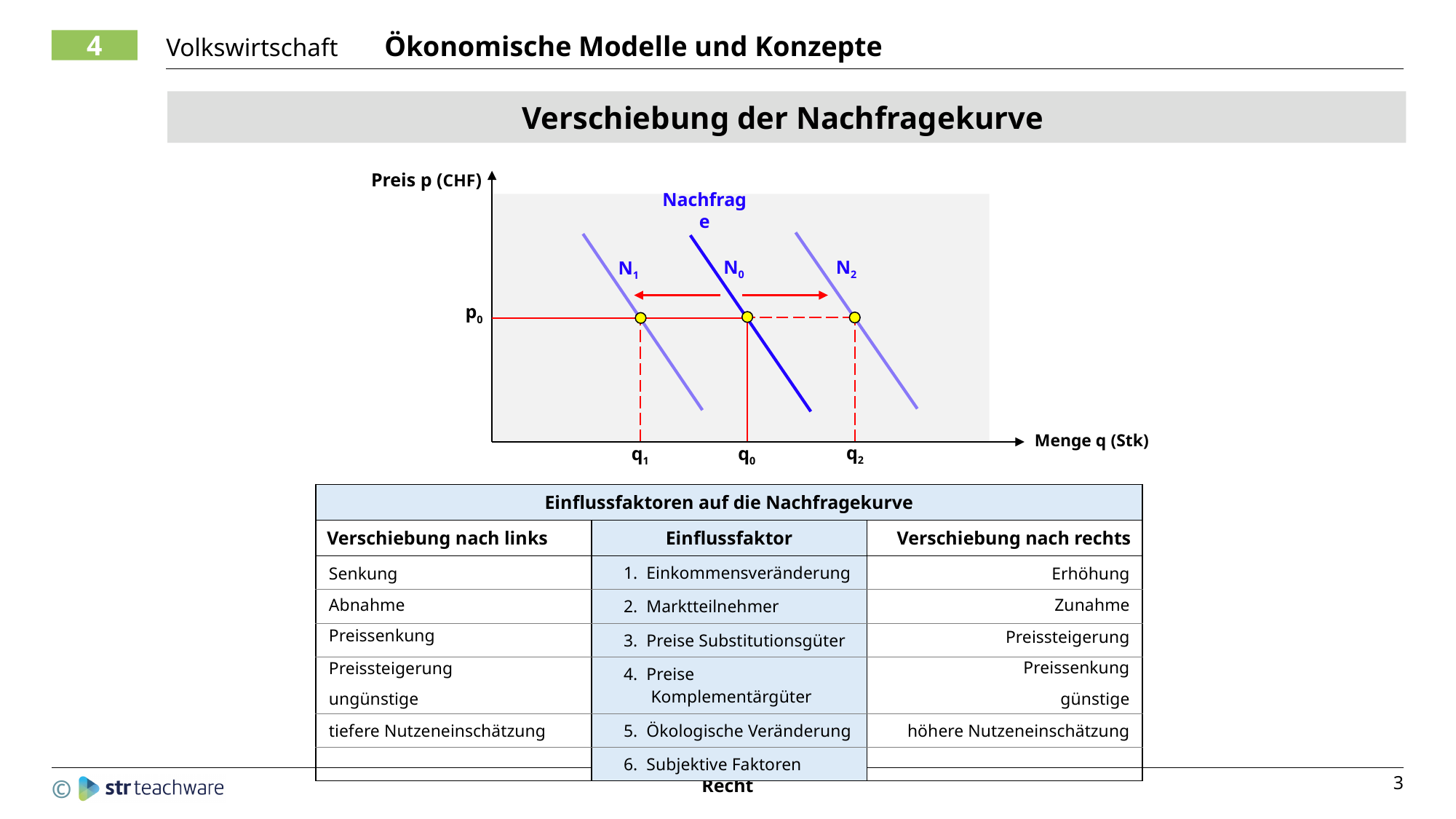
Which demand curve lies furthest to the left in the chart? N1 What is the label of the vertical axis of the chart? Preis p (CHF) How many demand curves are drawn in the chart? 3 Which demand curve passes through the point at q0 and p0? N0 Do the demand curves rise or fall as the quantity q increases along the x axis? fall What is the label of the horizontal axis of the chart? Menge q (Stk) At price p0, which quantity is larger, q1 or q2? q2 At price p0, which quantity is larger, q0 or q1? q0 Which demand curve lies furthest to the right in the chart? N2